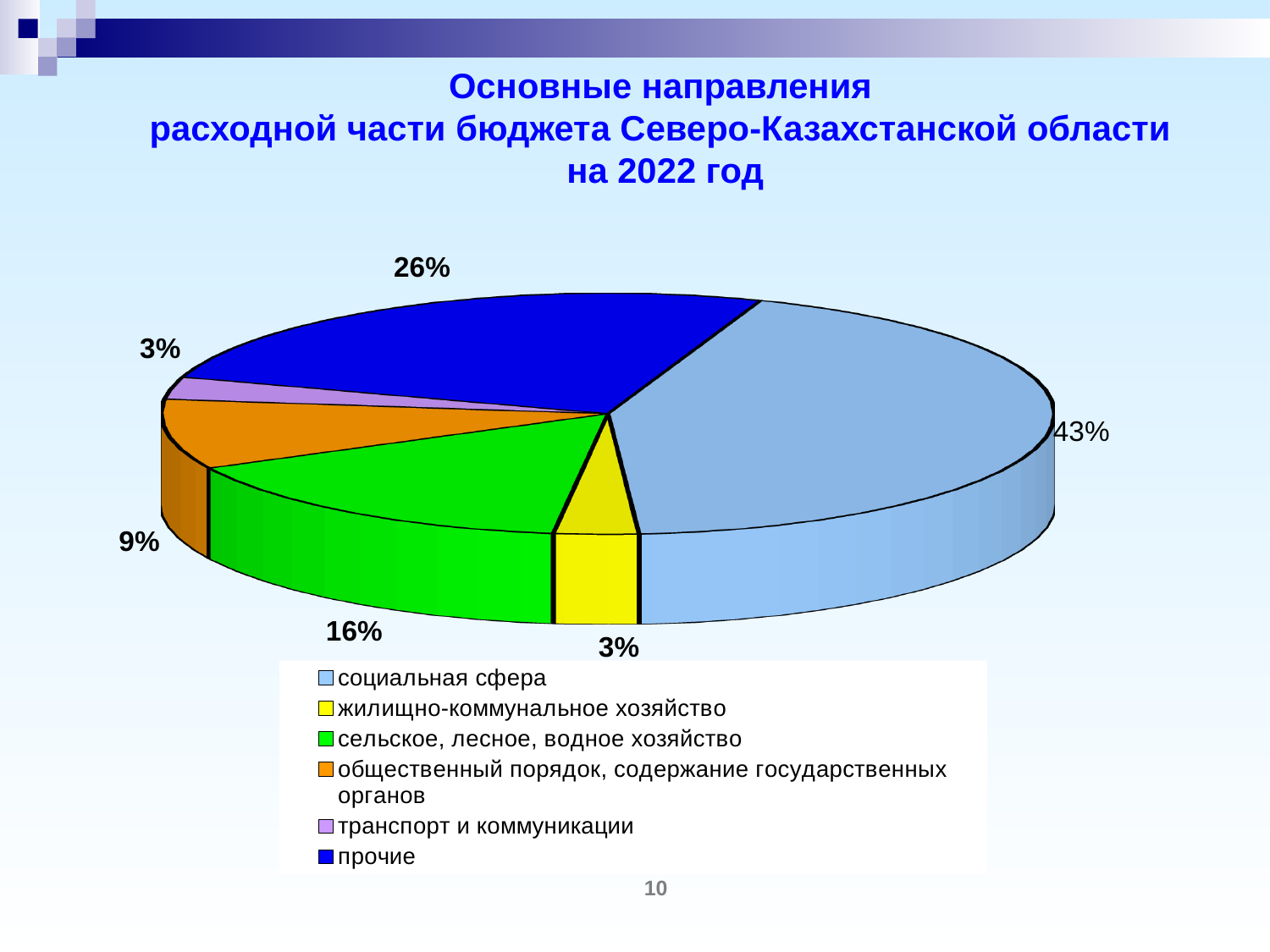
Which is larger: the share for прочие or the share for сельское, лесное, водное хозяйство? прочие What share of the budget expenditure goes to социальная сфера? 43% What share of the budget expenditure goes to общественный порядок, содержание государственных органов? 9% What is the difference in percentage points between the share for социальная сфера and the share for прочие? 17% How many categories does the legend list? 6 What share of the budget expenditure goes to сельское, лесное, водное хозяйство? 16% What share of the budget expenditure goes to транспорт и коммуникации? 3% What colour is the slice for жилищно-коммунальное хозяйство? yellow Which category has the largest share of the pie? социальная сфера What is the combined share of сельское, лесное, водное хозяйство and общественный порядок, содержание государственных органов? 25% What kind of chart is shown on the slide? pie chart What share of the budget expenditure goes to прочие? 26%